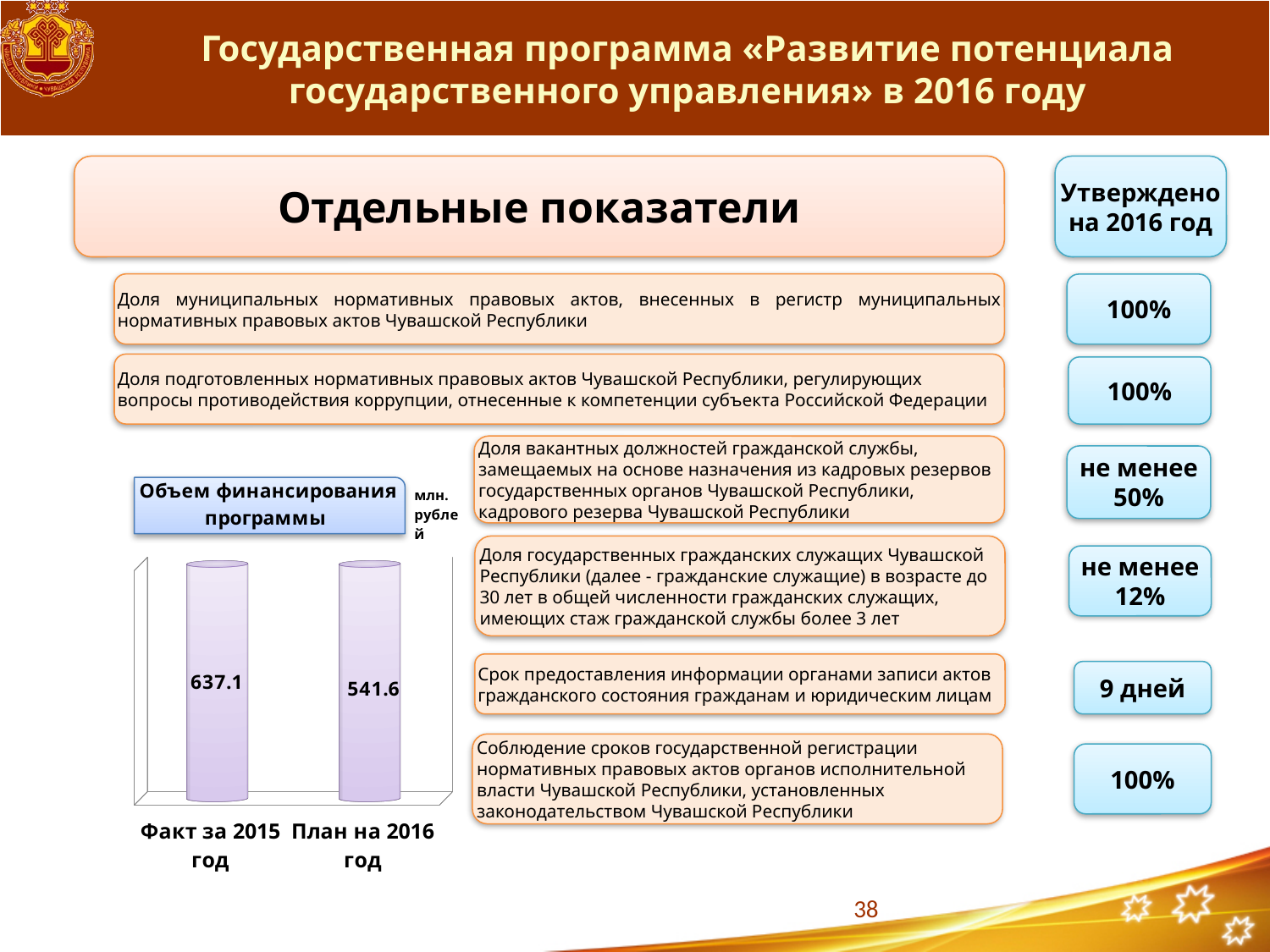
What is the difference between the values for "Факт за 2015 год" and "План на 2016 год" in the chart "Объем финансирования программы"? 95.5 Which category has the highest value in the chart "Объем финансирования программы"? Факт за 2015 год Which category has the lowest value in the chart "Объем финансирования программы"? План на 2016 год What is the value for "План на 2016 год" in the chart "Объем финансирования программы"? 541.6 What is the title of the chart on the slide? Объем финансирования программы In the chart "Объем финансирования программы", which is larger: the value for "Факт за 2015 год" or for "План на 2016 год"? Факт за 2015 год What unit is indicated for the values in the chart "Объем финансирования программы"? млн. рублей How many categories are shown in the chart "Объем финансирования программы"? 2 What kind of chart is "Объем финансирования программы"? Bar chart Do the values rise or fall from "Факт за 2015 год" to "План на 2016 год" in the chart "Объем финансирования программы"? Fall What is the value for "Факт за 2015 год" in the chart "Объем финансирования программы"? 637.1